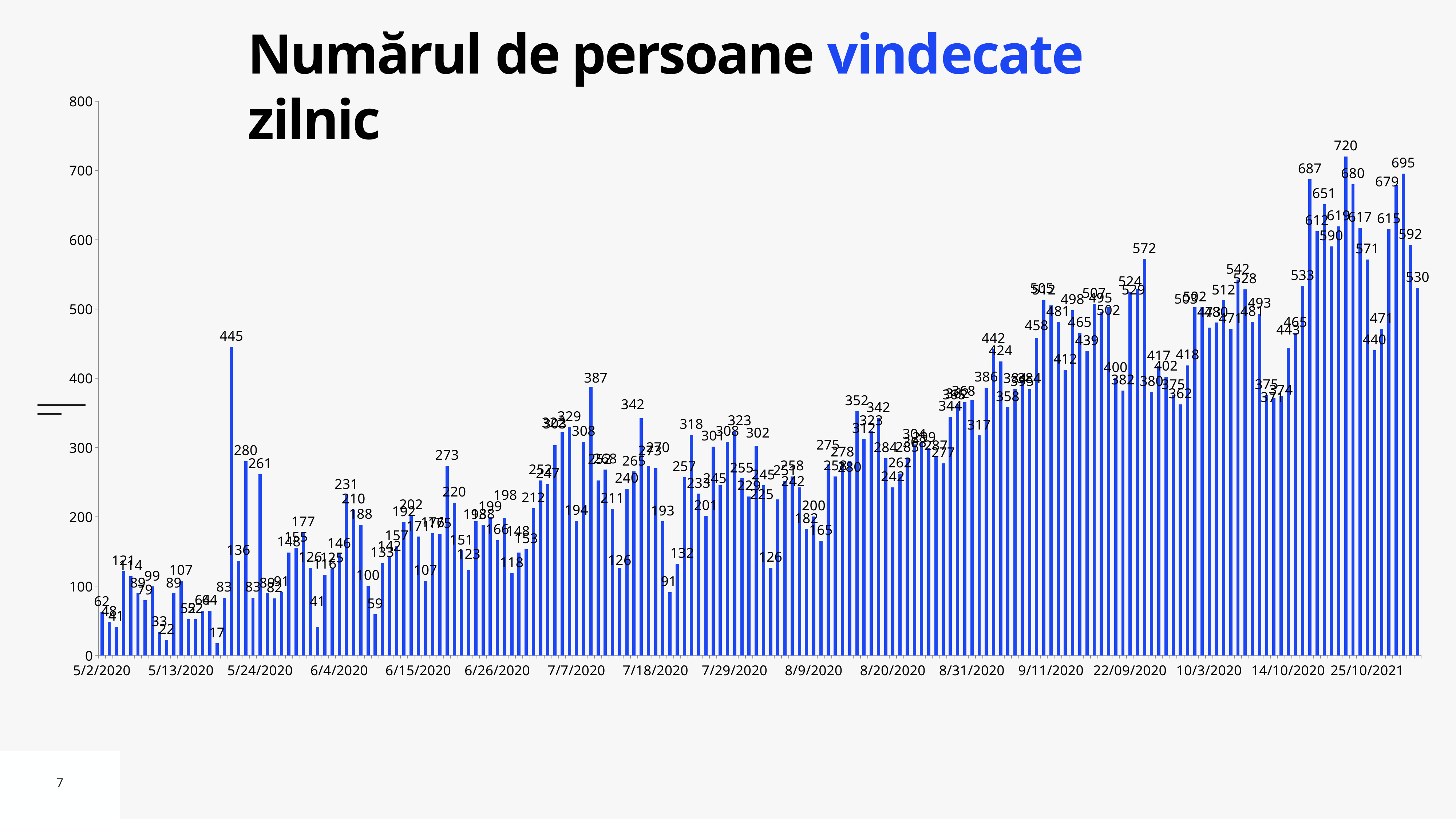
Which is larger, the bar labelled 720 or the bar labelled 695? 720 What is the title of the chart? Numărul de persoane vindecate zilnic What is the lowest value shown in the chart? 17 What kind of chart is shown on the slide? bar chart What is the highest value shown in the chart? 720 What is the difference between the last bar (530) and the first bar (62)? 468 Is the value for 5/2/2020 greater or less than 100? less How many date labels are shown on the x axis? 17 What is the value of the last bar on the right of the chart? 530 What is the difference between the highest value (720) and the lowest value (17) in the chart? 703 What is the value of the first bar, at 5/2/2020? 62 Overall, do the values rise or fall from left to right along the x axis? rise